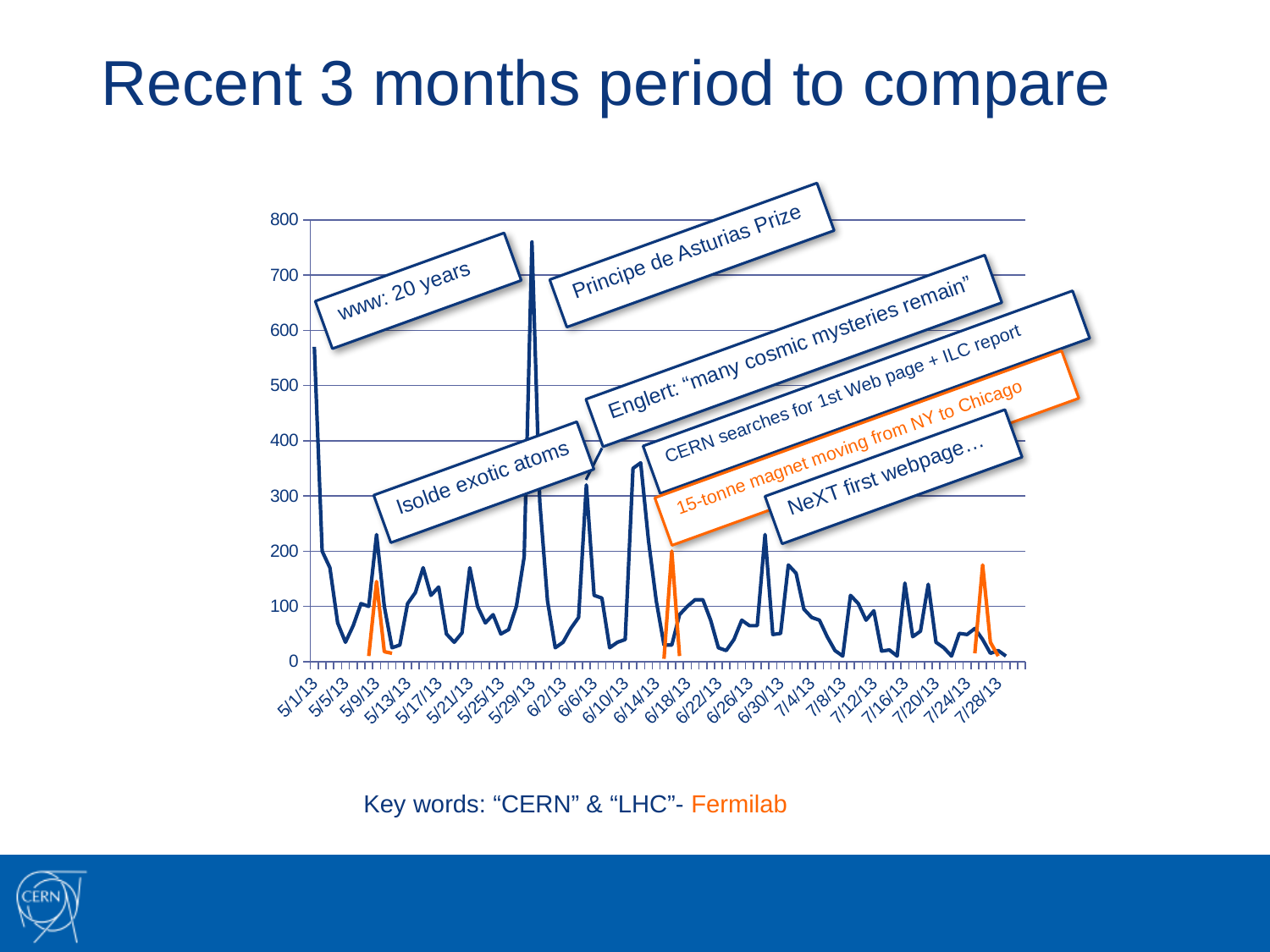
Which annotation box labels the highest peak of the blue line? Principe de Asturias Prize Is the value of the blue peak near 6/10/13 greater or less than 300? greater Is the value of the blue line at 5/1/13 greater or less than 500? greater Is the value of the orange peak near 5/9/13 greater or less than 200? less Which is larger: the blue peak in late May 2013 (around 5/29/13) or the blue peak at 5/1/13? the peak around 5/29/13 Which key word does the orange line represent according to the text below the chart? Fermilab What is the highest value shown on the vertical axis of the chart? 800 What kind of chart is shown on the slide? line chart